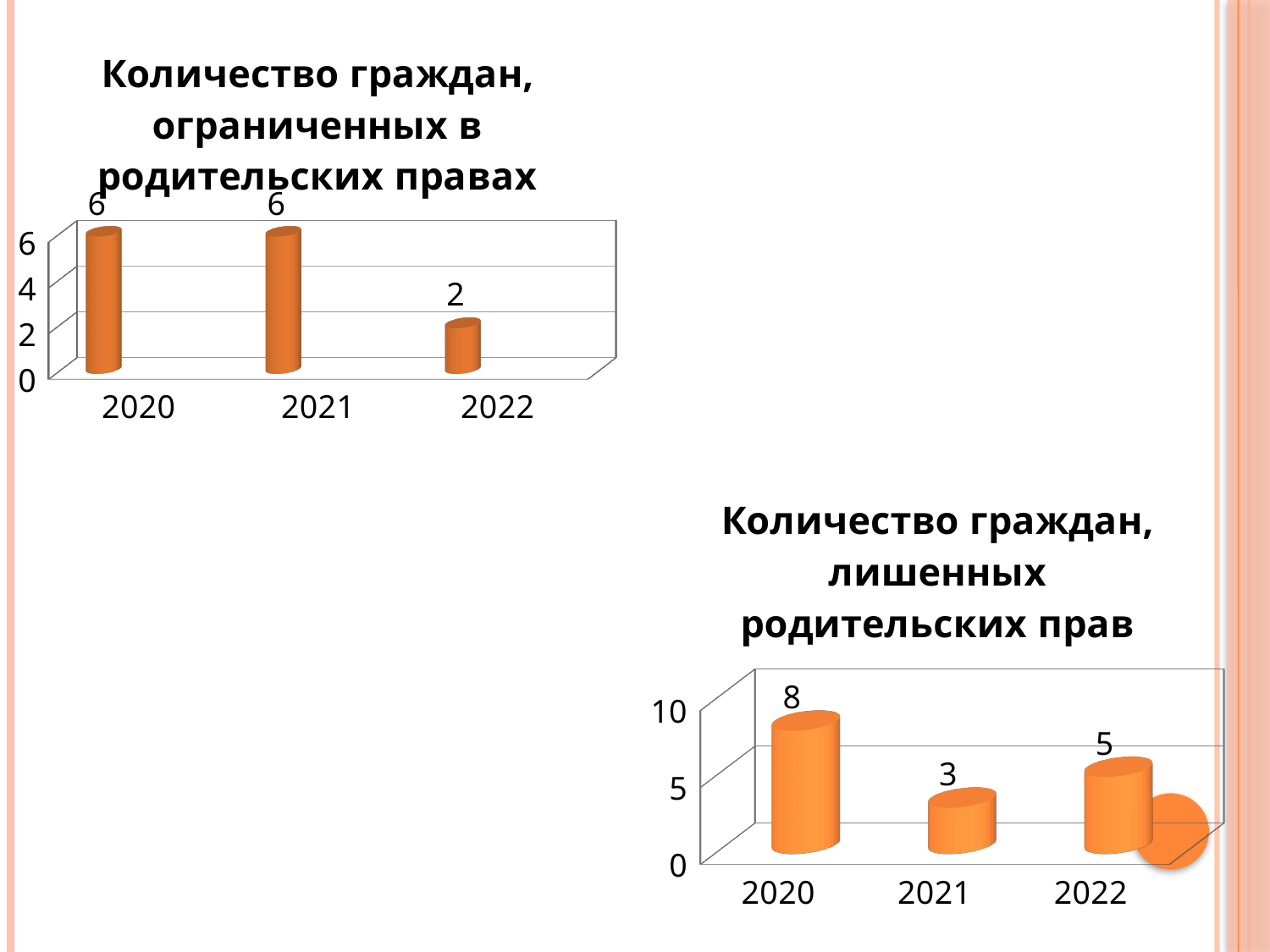
In the chart titled "Количество граждан, ограниченных в родительских правах" (top left), what is the value for 2020? 6 In the chart titled "Количество граждан, лишенных родительских прав" (bottom right), what is the value for 2020? 8 In the bottom-right chart, which is larger: the value for 2021 or the value for 2022? 2022 What type of chart is the bottom-right chart titled "Количество граждан, лишенных родительских прав"? Bar chart In the chart titled "Количество граждан, ограниченных в родительских правах" (top left), what is the value for 2022? 2 In the bottom-right chart, which year has the lowest value? 2021 In the top-left chart, which year has the lowest value? 2022 In the top-left chart, what is the difference between the values for 2021 and 2022? 4 In the bottom-right chart, what is the difference between the values for 2020 and 2022? 3 How many years are shown on the x axis of the top-left chart? 3 In the chart titled "Количество граждан, лишенных родительских прав" (bottom right), what is the value for 2021? 3 In the bottom-right chart, which year has the highest value? 2020